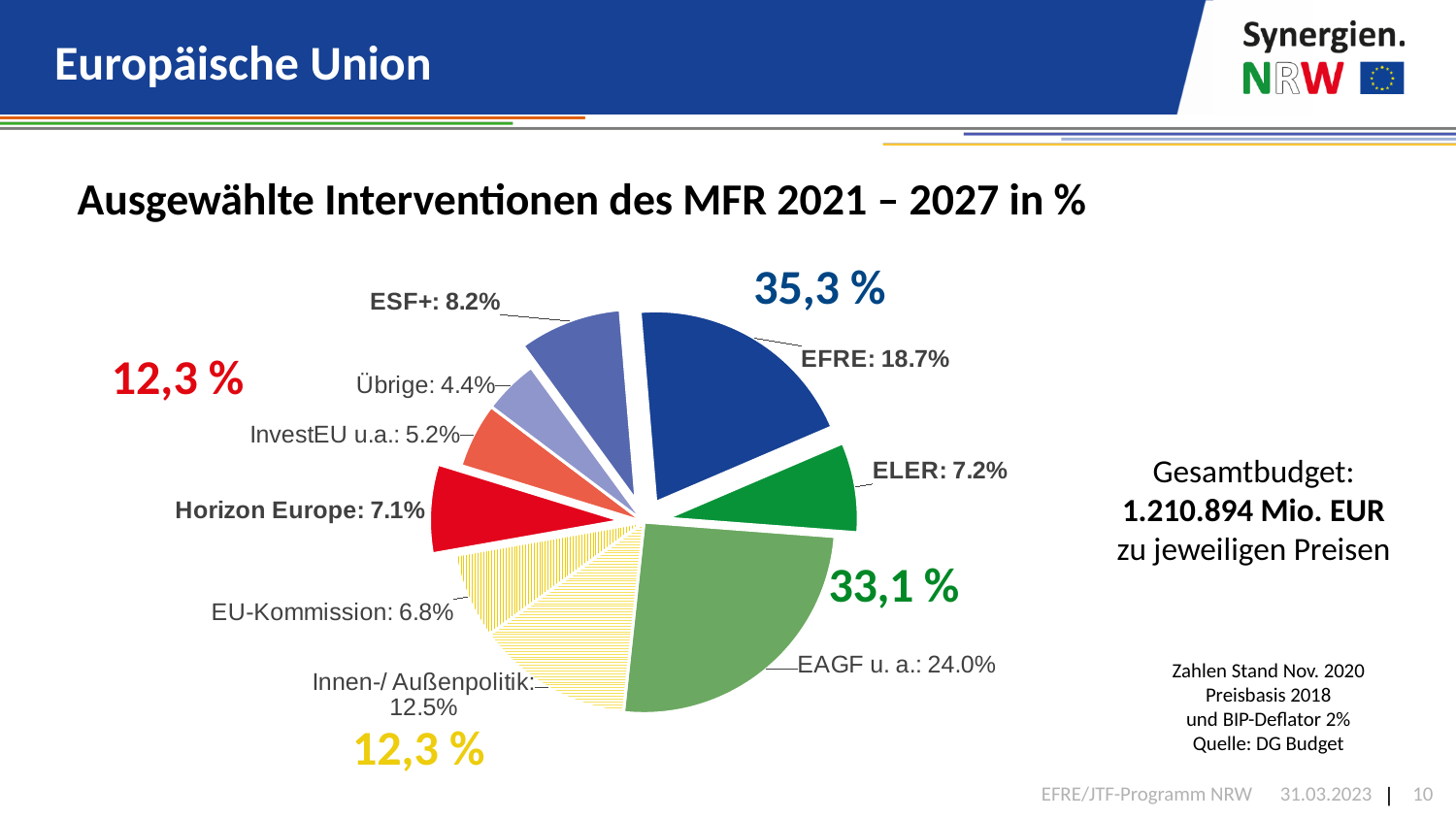
What share does EFRE have in the pie chart? 18.7% Which slice of the pie chart is the smallest? Übrige What type of chart is shown on the slide? pie chart What share does Innen-/Außenpolitik have in the pie chart? 12.5% Which slice of the pie chart is the largest? EAGF u. a. Which is larger, the share of EFRE or the share of EAGF u. a.? EAGF u. a. What is the difference between the EFRE share and the ESF+ share? 10.5% How many slices does the pie chart have? 9 What share does EAGF u. a. have in the pie chart? 24.0% What is the title of the chart? Ausgewählte Interventionen des MFR 2021 – 2027 in % What share does ESF+ have in the pie chart? 8.2% What is the Gesamtbudget stated next to the chart? 1.210.894 Mio. EUR